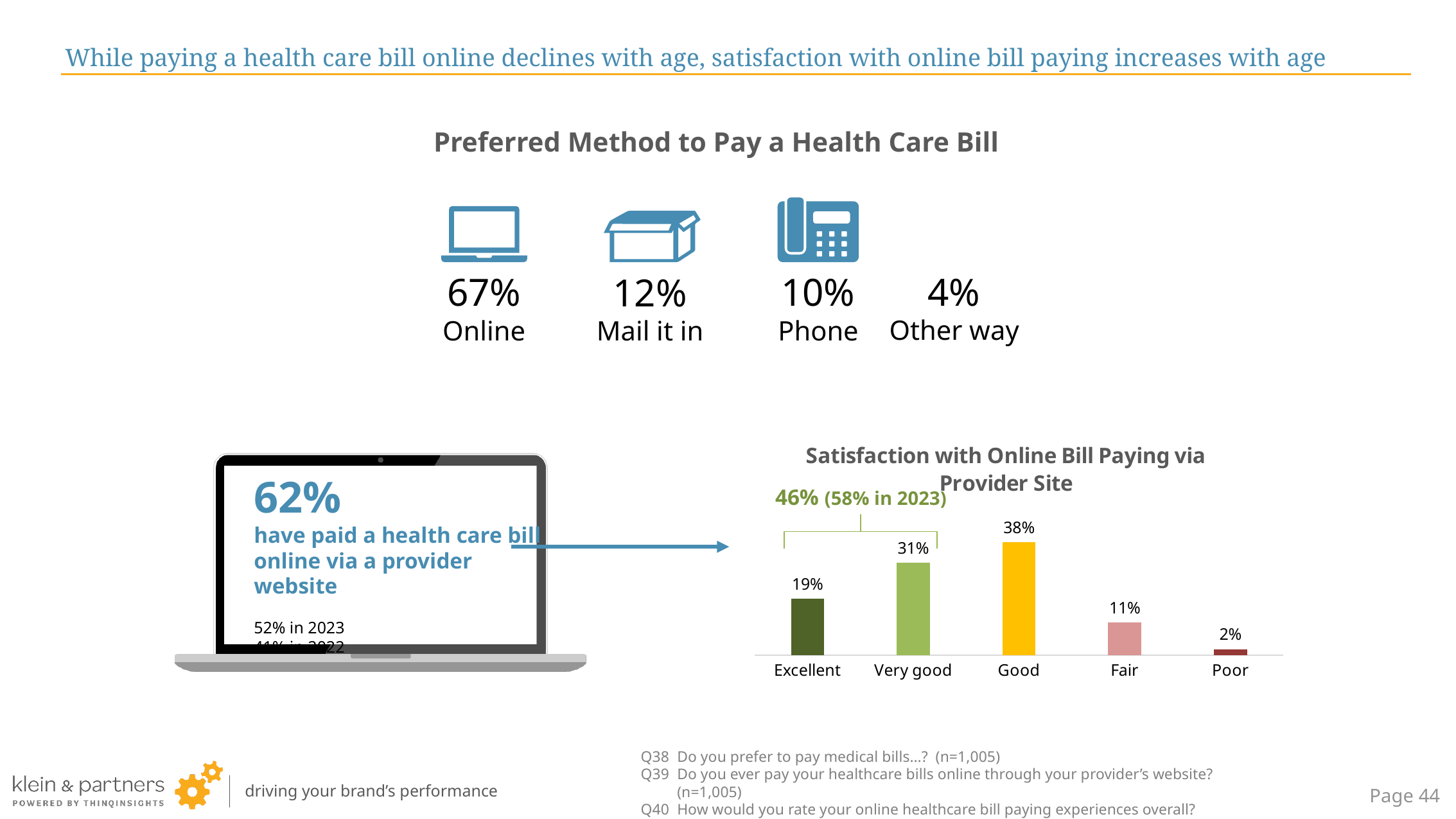
In the 'Satisfaction with Online Bill Paying via Provider Site' chart, which category has the lowest value? Poor In the 'Satisfaction with Online Bill Paying via Provider Site' chart, which is larger, the value for Very good or the value for Fair? Very good In the 'Satisfaction with Online Bill Paying via Provider Site' chart, which category has the highest value? Good In the 'Satisfaction with Online Bill Paying via Provider Site' chart, what is the value for Excellent? 19% In the 'Satisfaction with Online Bill Paying via Provider Site' chart, what is the value for Good? 38% In the 'Satisfaction with Online Bill Paying via Provider Site' chart, what combined value is shown for Excellent and Very good together? 46% In the 'Preferred Method to Pay a Health Care Bill' graphic, what is the difference between Mail it in and Phone? 2% In the 'Satisfaction with Online Bill Paying via Provider Site' chart, what is the difference between the values for Good and Very good? 7% In the 'Preferred Method to Pay a Health Care Bill' graphic, what percentage prefer to pay Online? 67% What kind of chart is 'Satisfaction with Online Bill Paying via Provider Site'? Bar chart How many categories are shown in the 'Satisfaction with Online Bill Paying via Provider Site' chart? 5 In the 'Satisfaction with Online Bill Paying via Provider Site' chart, what is the value for Poor? 2%